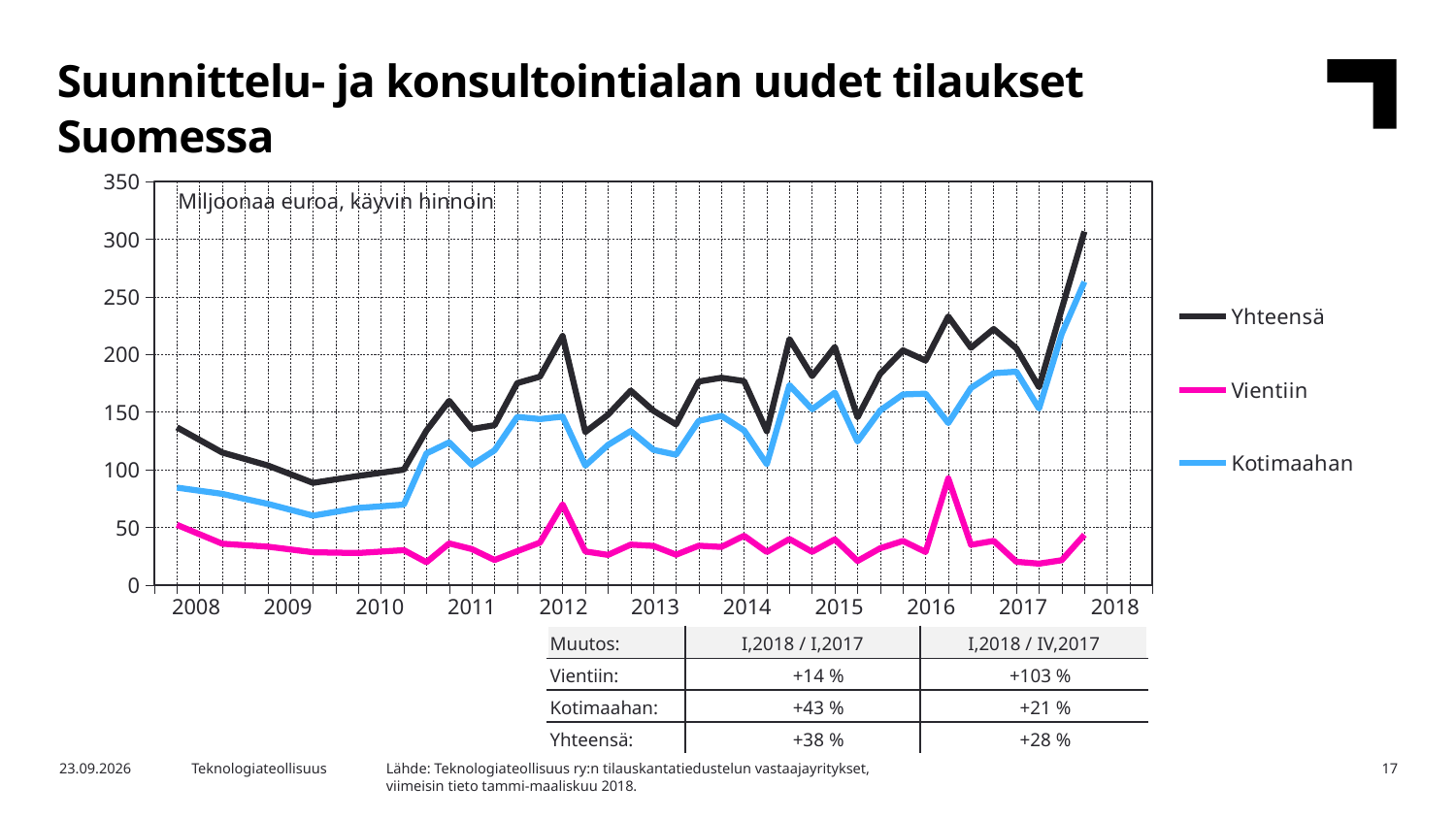
Does the Yhteensä line rise or fall between 2017 and 2018? rise Which is larger at the last point (2018): Kotimaahan or Vientiin? Kotimaahan Which series has the highest values throughout the chart? Yhteensä What kind of chart is shown on the slide? line chart Which series is drawn in magenta (pink)? Vientiin Is the peak value of Vientiin in 2016 greater or less than 100? less How many series does the legend list? 3 What is the title of the slide's chart? Suunnittelu- ja konsultointialan uudet tilaukset Suomessa Is the lowest value of Yhteensä around 2009 greater or less than 100? less Which series has the lowest values throughout the chart? Vientiin Is the value of Yhteensä at the last point (2018) greater or less than 250? greater